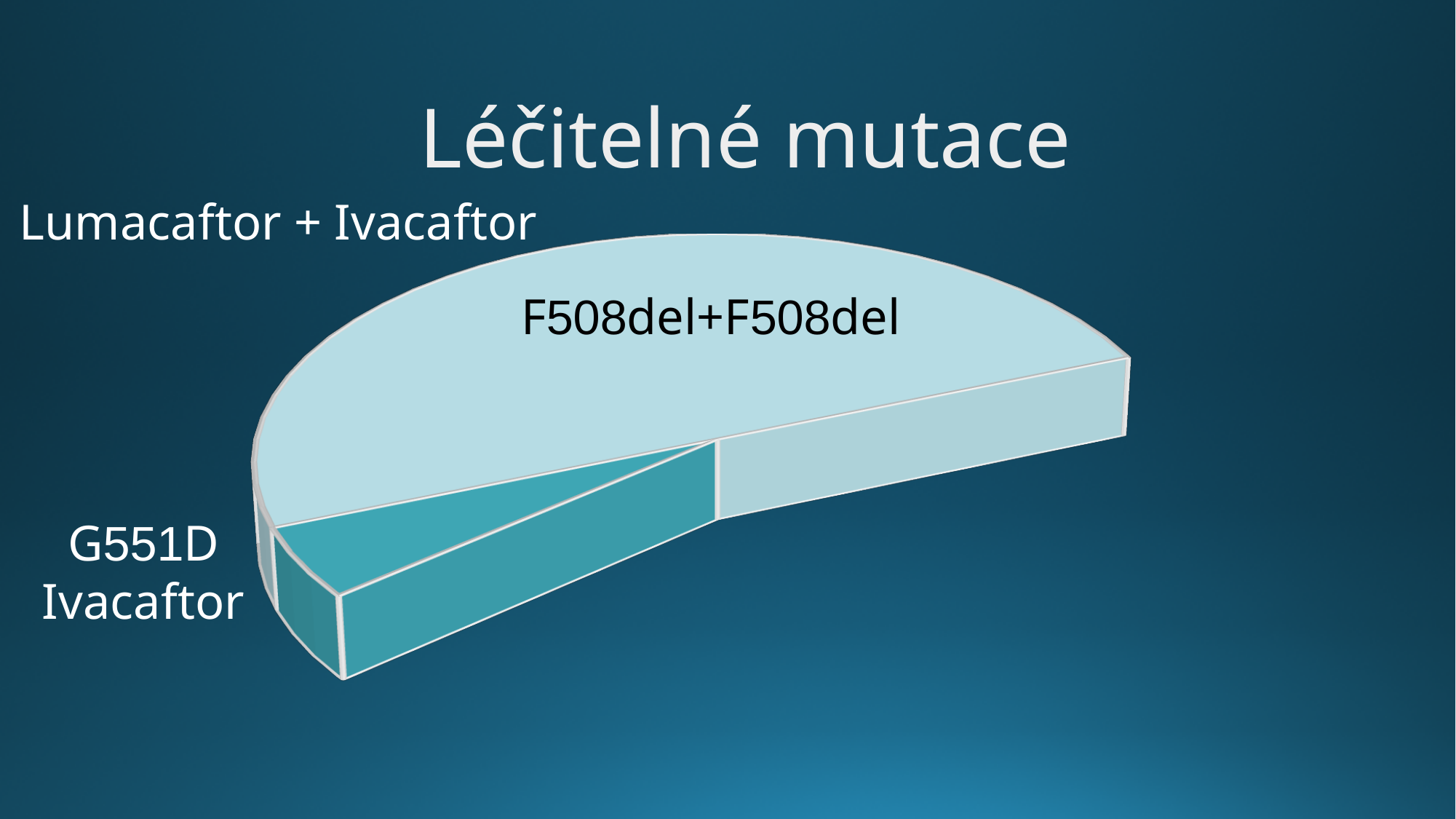
Which slice of the pie chart is the largest? F508del+F508del Which slice is larger, F508del+F508del or G551D? F508del+F508del What kind of chart is shown on the slide? pie chart What is the title of the slide containing the pie chart? Léčitelné mutace How many slices of the pie chart are labelled with a mutation name? 2 Which drug combination is written next to the F508del+F508del slice? Lumacaftor + Ivacaftor